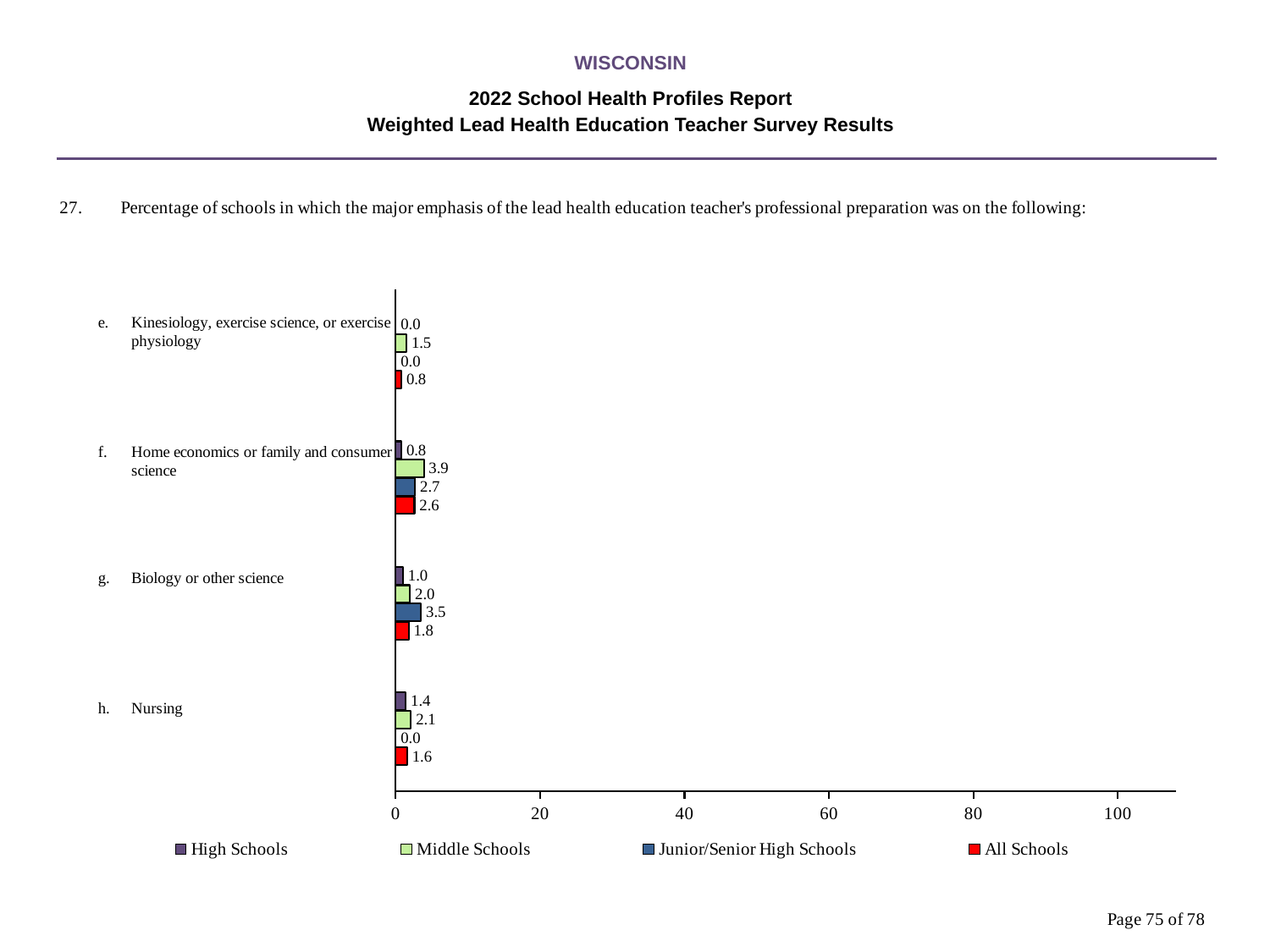
What is the value for Middle Schools for Home economics or family and consumer science? 3.9 What kind of chart is shown on the slide? bar chart What is the value for High Schools for Kinesiology, exercise science, or exercise physiology? 0.0 How many categories are shown on the chart? 4 How many series does the legend list? 4 What is the value for Junior/Senior High Schools for Biology or other science? 3.5 Is the value for Middle Schools for Home economics or family and consumer science greater or less than 20? less Which category has the highest value for Middle Schools? Home economics or family and consumer science Which category has the lowest value for All Schools? Kinesiology, exercise science, or exercise physiology Which is larger for Biology or other science: the Junior/Senior High Schools value or the Middle Schools value? Junior/Senior High Schools What is the value for All Schools for Nursing? 1.6 What is the difference between the Middle Schools and High Schools values for Home economics or family and consumer science? 3.1